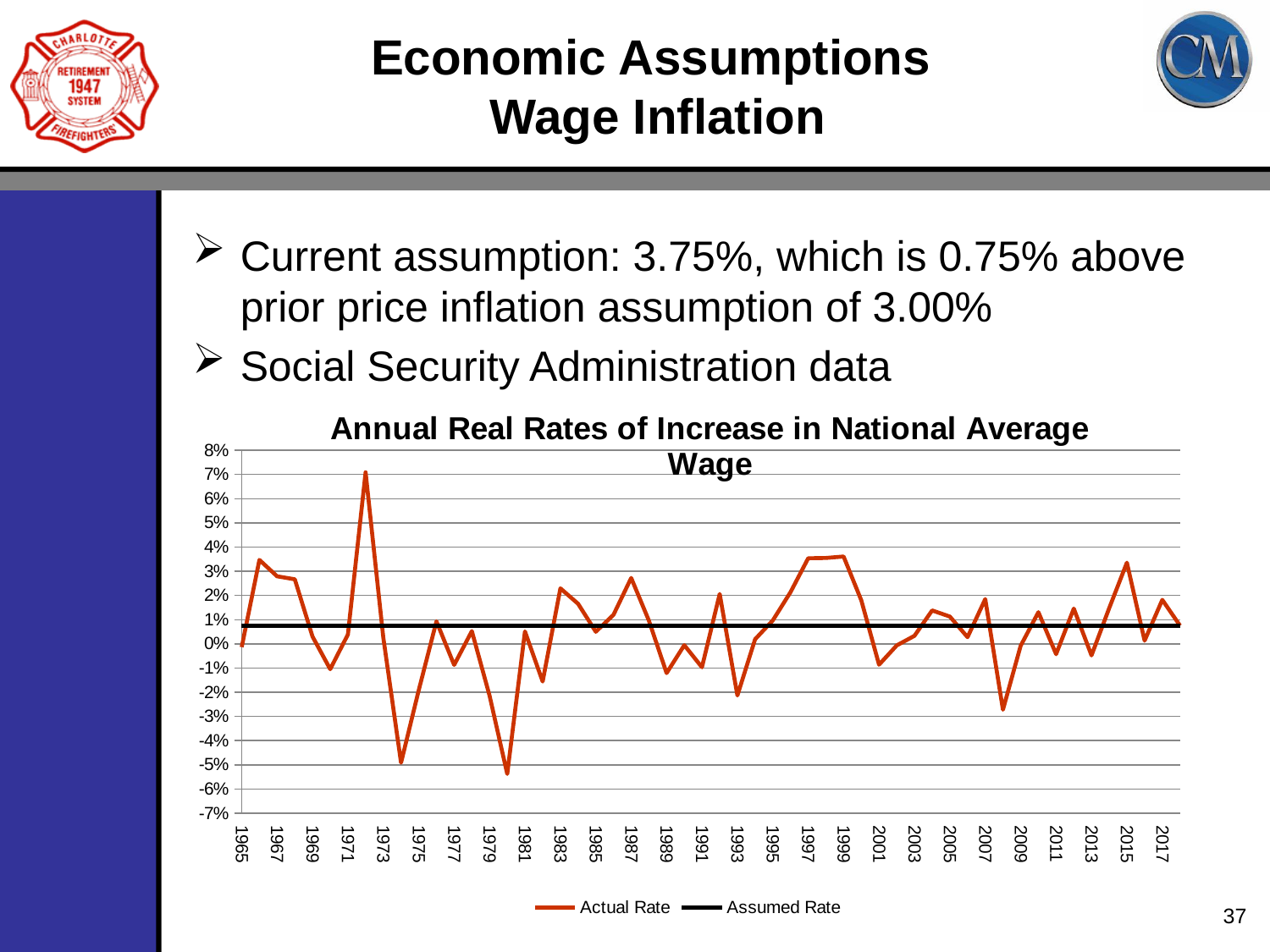
What kind of chart is shown on the slide? line chart Is the Assumed Rate line greater or less than 1%? less Is the Actual Rate for 1998 greater or less than 3%? greater What is the title of the chart? Annual Real Rates of Increase in National Average Wage Which series is drawn in black in the chart? Assumed Rate Is the Actual Rate for 1972 greater or less than 5%? greater Which is larger, the Actual Rate in 1972 or the Actual Rate in 1998? 1972 How many series does the chart legend list? 2 In which year does the Actual Rate reach its highest value? 1972 Does the Assumed Rate rise, fall, or stay flat across the years shown? stays flat